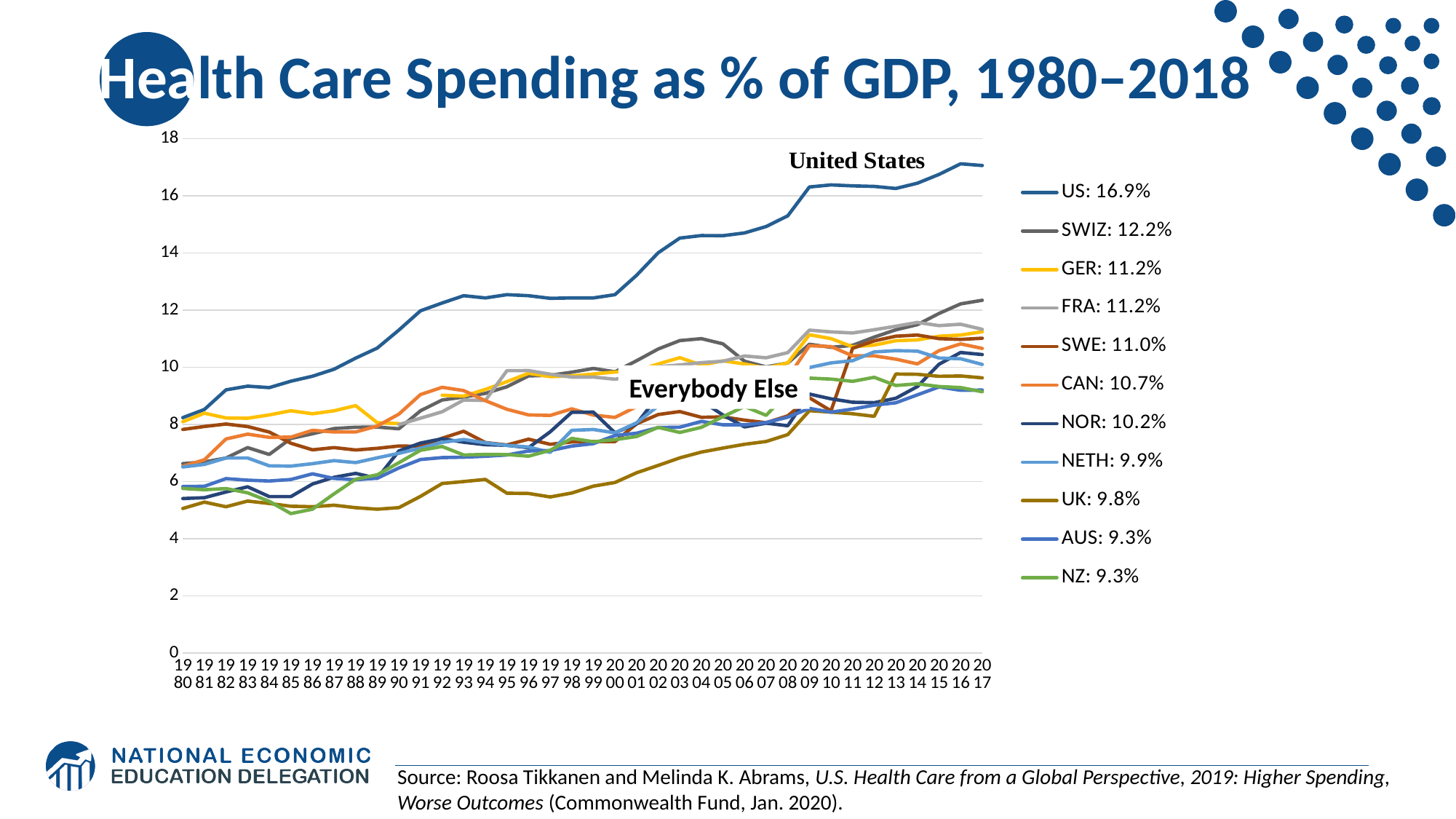
What value does the legend give for CAN? 10.7% Which has the larger legend value, SWE or CAN? SWE What value does the legend give for the US? 16.9% Does the United States line rise or fall from 1980 to 2017? rises Is the value for the United States in 2017 greater or less than 16? greater Which country has the highest value in the legend? US How many series does the legend list? 11 What value does the legend give for SWIZ? 12.2% What kind of chart is shown on the slide? line chart What value does the legend give for the UK? 9.8% What is the difference between the legend values for the US and SWIZ? 4.7 percentage points What is the title of the chart? Health Care Spending as % of GDP, 1980–2018